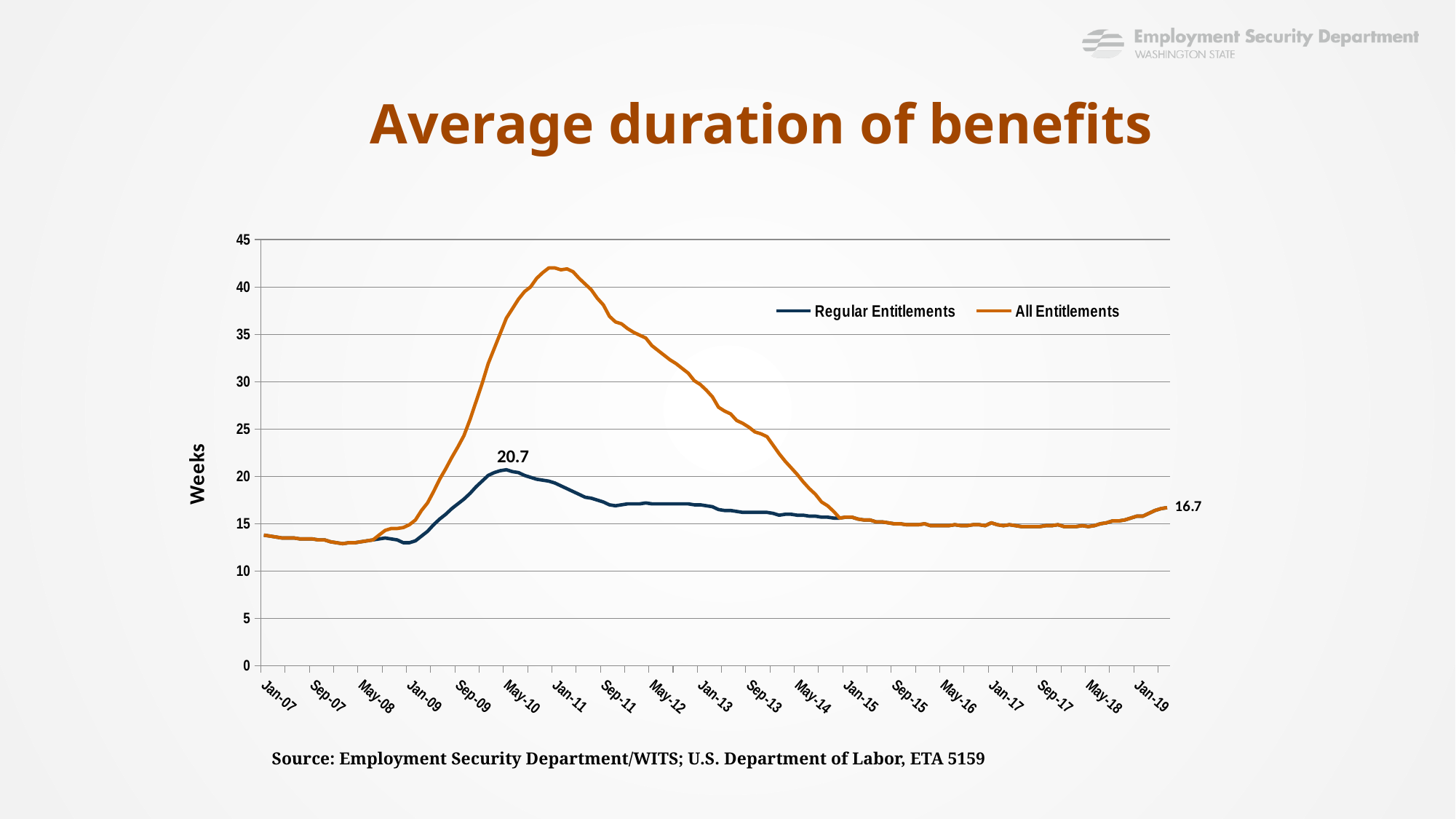
Is the value for All Entitlements at Jan-13 greater or less than 25? greater What value is labeled at the right end of the chart, around Jan-19? 16.7 Is the value for Regular Entitlements at Jan-07 greater or less than 15? less Is the peak value of the All Entitlements line greater or less than 40? greater How many series does the legend list? 2 What is the peak value labeled on the Regular Entitlements line? 20.7 What kind of chart is shown on the slide? line chart What are the two series named in the legend? Regular Entitlements and All Entitlements Does the All Entitlements line rise or fall between Jan-11 and Jan-15? fall Around Jan-11, which series has the higher value, Regular Entitlements or All Entitlements? All Entitlements Which series reaches the higher peak value? All Entitlements What is the label on the vertical axis? Weeks